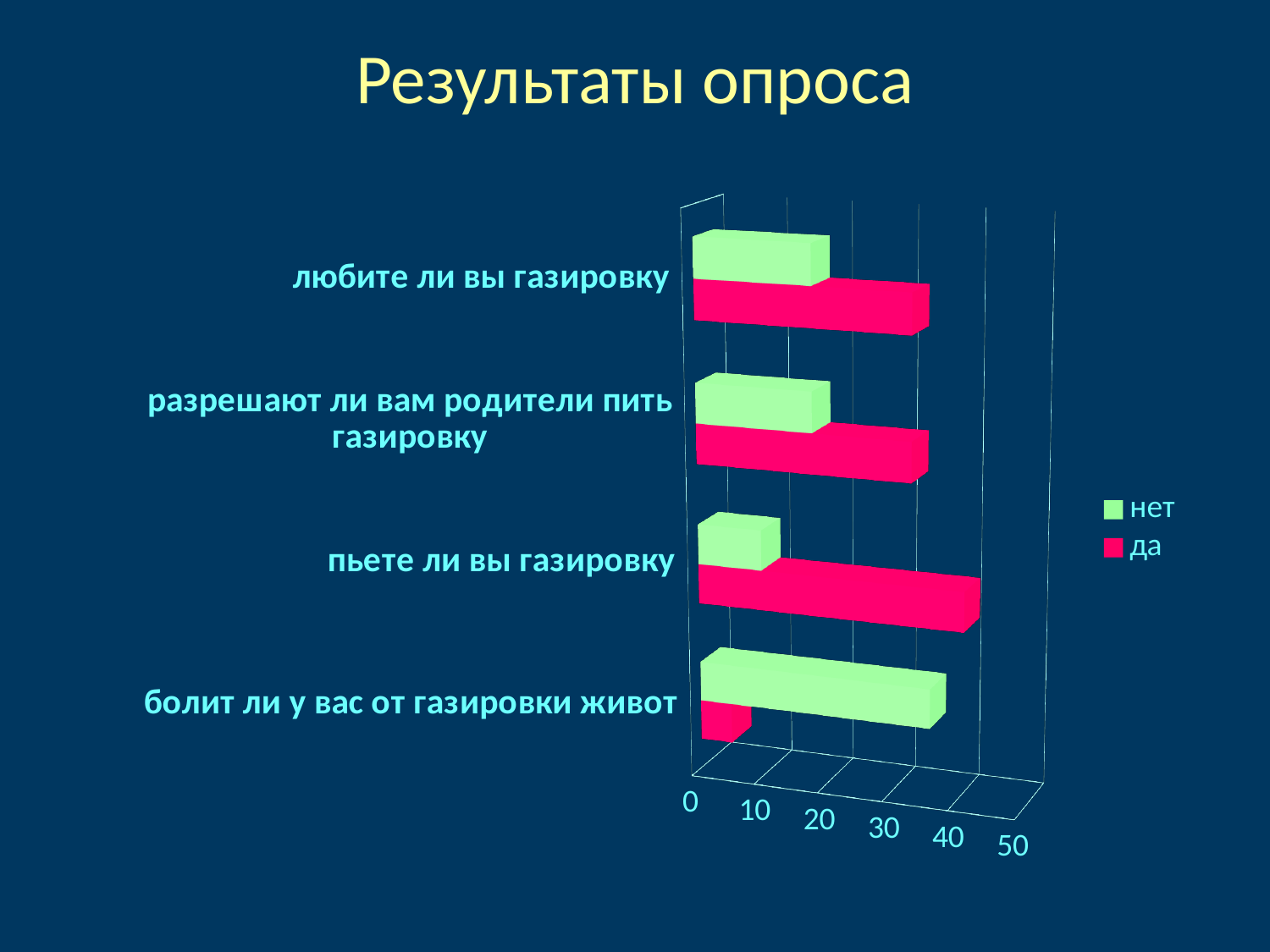
For "пьете ли вы газировку", which is larger: да or нет? да For "болит ли у вас от газировки живот", which is larger: да or нет? нет What are the two entries in the chart legend? нет, да Which category has the lowest value for да? болит ли у вас от газировки живот Which category has the highest value for да? пьете ли вы газировку Is the value for да for "болит ли у вас от газировки живот" greater or less than 10? less What is the title of the slide? Результаты опроса Which category has the highest value for нет? болит ли у вас от газировки живот How many survey questions (categories) are shown on the chart? 4 What kind of chart is shown on the slide? bar chart Is the value for да for "пьете ли вы газировку" greater or less than 30? greater How many series does the legend list? 2